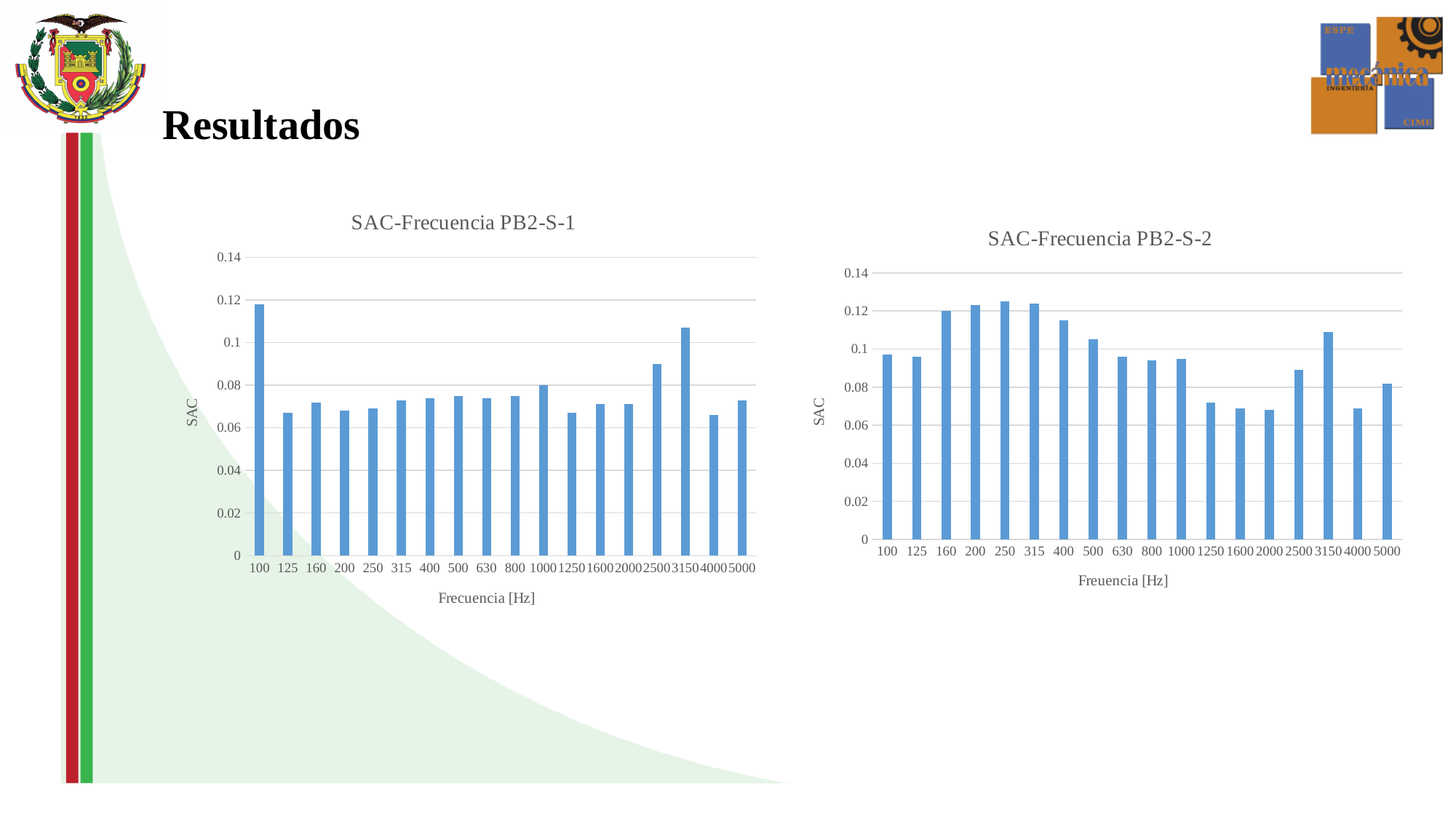
In the chart 'SAC-Frecuencia PB2-S-2', which is larger, the value for 160 Hz or the value for 1250 Hz? 160 Hz In the chart 'SAC-Frecuencia PB2-S-1', is the value for 125 Hz greater or less than 0.08? less In the chart 'SAC-Frecuencia PB2-S-1', how many frequency categories are shown on the x axis? 18 In the chart 'SAC-Frecuencia PB2-S-2', is the value for 1600 Hz greater or less than 0.08? less In the chart 'SAC-Frecuencia PB2-S-2', is the value for 250 Hz greater or less than 0.12? greater What kind of chart is 'SAC-Frecuencia PB2-S-2'? bar chart In the chart 'SAC-Frecuencia PB2-S-2', how many bars are plotted? 18 What kind of chart is 'SAC-Frecuencia PB2-S-1'? bar chart In the chart 'SAC-Frecuencia PB2-S-1', which frequency has the highest SAC value? 100 In the chart 'SAC-Frecuencia PB2-S-2', do the values rise or fall from 250 Hz to 2000 Hz? fall In the chart 'SAC-Frecuencia PB2-S-1', which is larger, the value for 3150 Hz or the value for 4000 Hz? 3150 Hz